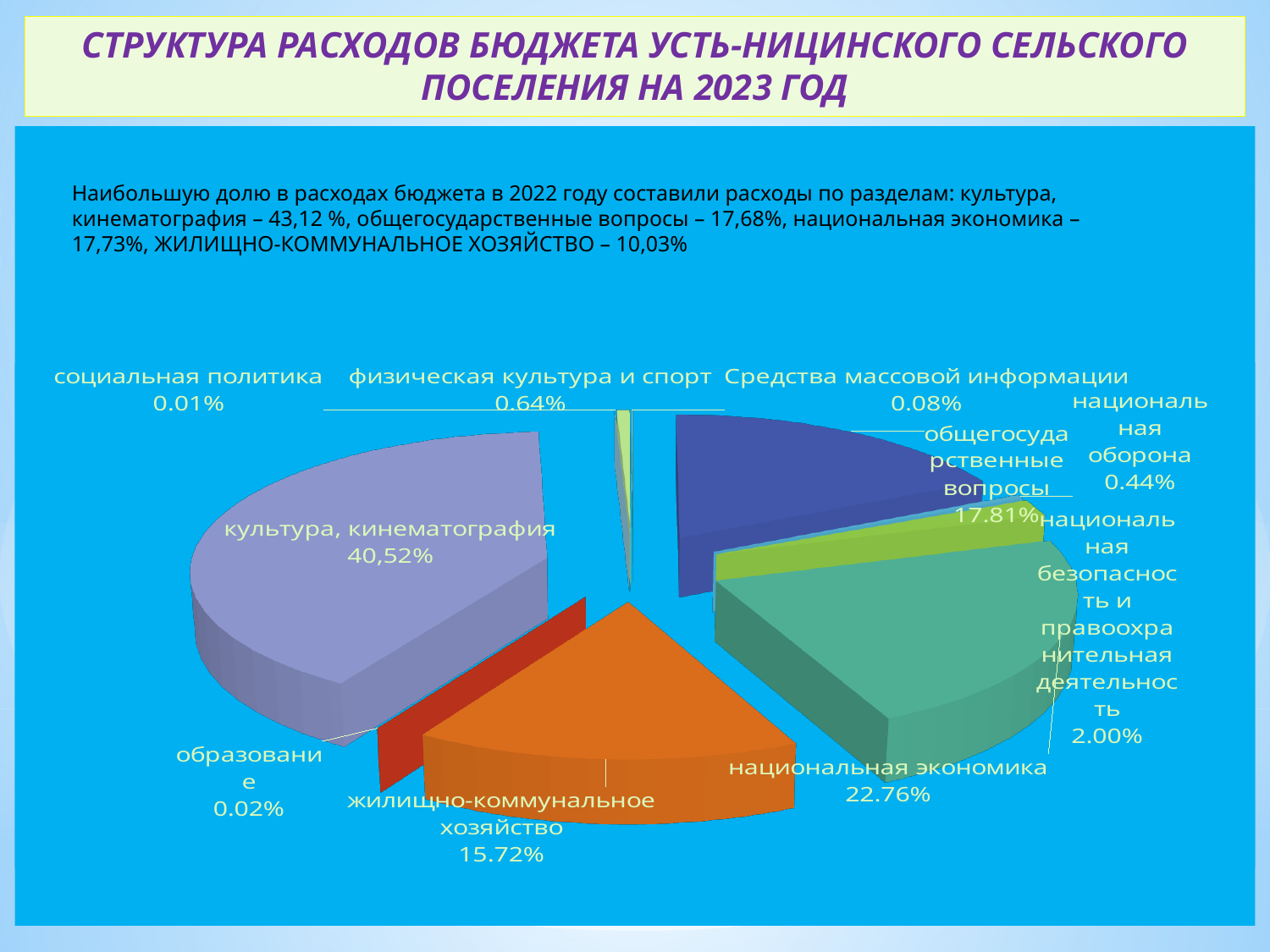
Which category has the largest share of the budget expenditures in the pie chart? культура, кинематография Which category has the smallest share in the pie chart? социальная политика Which is larger: 'национальная экономика' or 'общегосударственные вопросы'? национальная экономика What value is shown for 'национальная безопасность и правоохранительная деятельность'? 2.00% What is the difference between the shares of 'национальная экономика' and 'жилищно-коммунальное хозяйство'? 7.04% What value is shown for 'физическая культура и спорт'? 0.64% How many categories (slices) does the pie chart show? 10 What kind of chart is shown on the slide? pie chart What share does 'национальная экономика' have in the pie chart? 22.76% What value is shown for 'общегосударственные вопросы'? 17.81% What value is shown for 'жилищно-коммунальное хозяйство'? 15.72% What value is shown for 'национальная оборона'? 0.44%